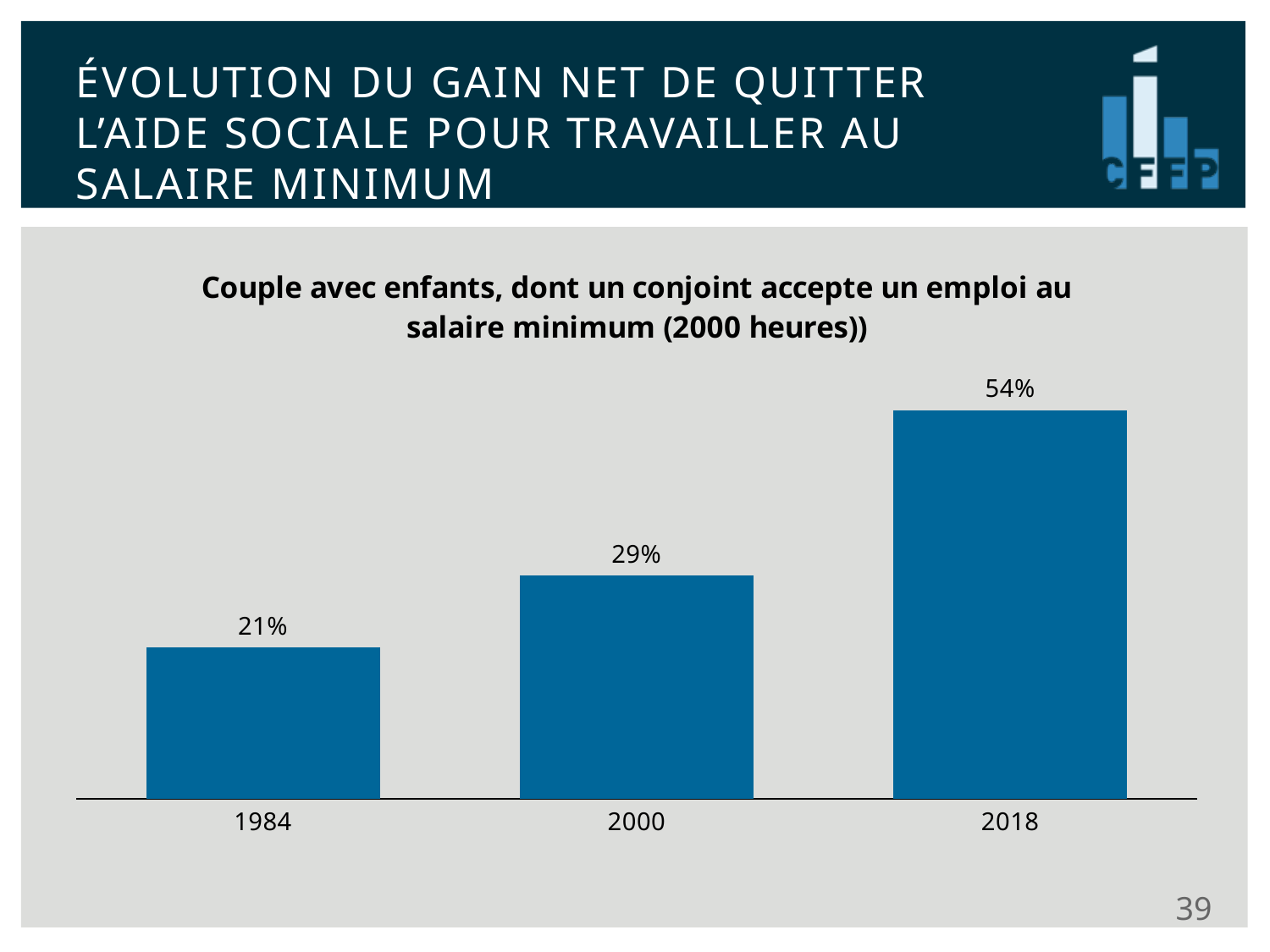
What is the value for 2000? 29% What is the difference between the values for 2018 and 1984? 33% Which year has the lowest value? 1984 Which is larger, the value for 2000 or the value for 2018? 2018 What is the title of the chart? Couple avec enfants, dont un conjoint accepte un emploi au salaire minimum (2000 heures)) What kind of chart is this? Bar chart What is the value for 2018? 54% What is the difference between the values for 2000 and 1984? 8% Do the values rise or fall from 1984 to 2018? Rise What is the value for 1984? 21% Which year has the highest value? 2018 How many years are shown on the x axis? 3